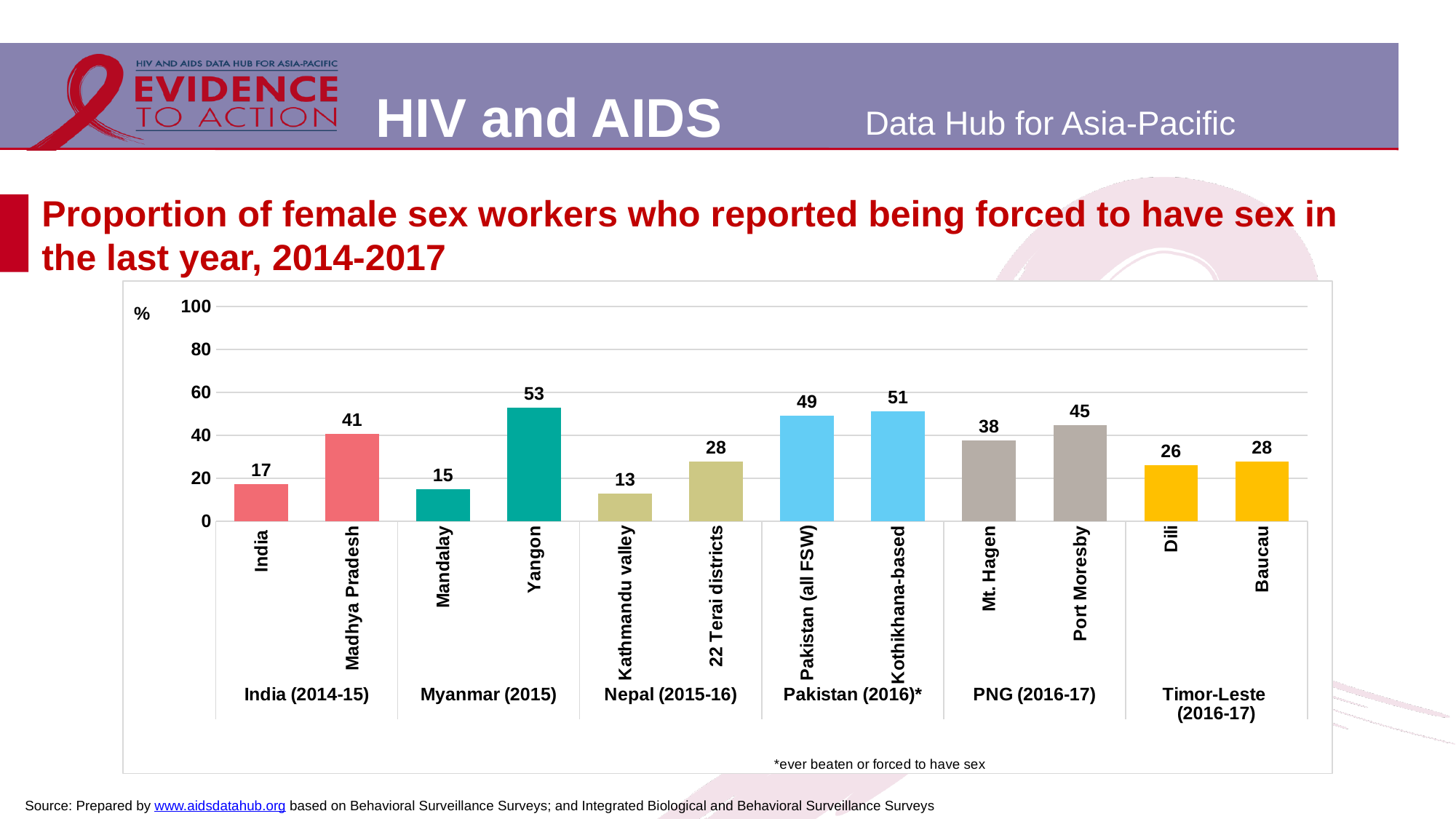
What is the value for Kathmandu valley? 13 What is the difference between the values for Madhya Pradesh and India? 24 How many bars are plotted in the chart? 12 Which category has the highest value? Yangon What is the value for Port Moresby? 45 What kind of chart is shown on the slide? bar chart What is the value for Yangon? 53 What is the maximum value shown on the y axis? 100 Which is larger, the value for Mt. Hagen or the value for Port Moresby? Port Moresby What is the difference between the values for Baucau and Dili? 2 Which category has the lowest value? Kathmandu valley Is the value for Kothikhana-based greater or less than 40? greater